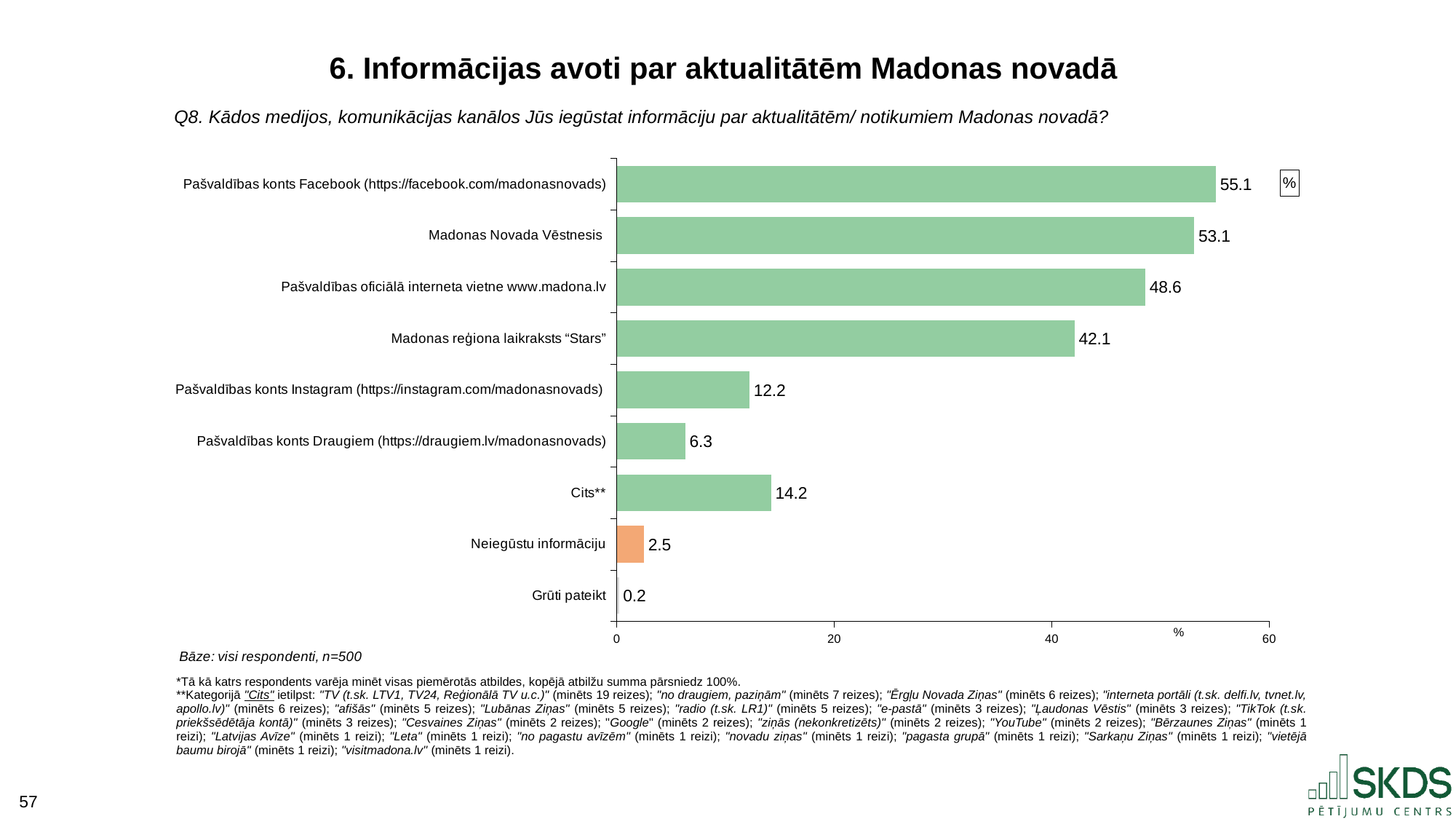
Is the value for Madonas reģiona laikraksts “Stars” greater or less than 40? greater What is the difference between the values for Pašvaldības oficiālā interneta vietne www.madona.lv and Madonas reģiona laikraksts “Stars”? 6.5 How many categories are shown in the chart? 9 What is the value for Pašvaldības konts Instagram (https://instagram.com/madonasnovads)? 12.2 What is the difference between the values for Pašvaldības konts Facebook (https://facebook.com/madonasnovads) and Madonas Novada Vēstnesis? 2.0 What is the value for Madonas Novada Vēstnesis? 53.1 Which is larger, the value for Cits** or the value for Pašvaldības konts Draugiem (https://draugiem.lv/madonasnovads)? Cits** What kind of chart is shown on the slide? bar chart What is the value for Neiegūstu informāciju? 2.5 Which category has the lowest value? Grūti pateikt Which category has the highest value? Pašvaldības konts Facebook (https://facebook.com/madonasnovads) Which bar is shown in a different colour (orange) from the others? Neiegūstu informāciju